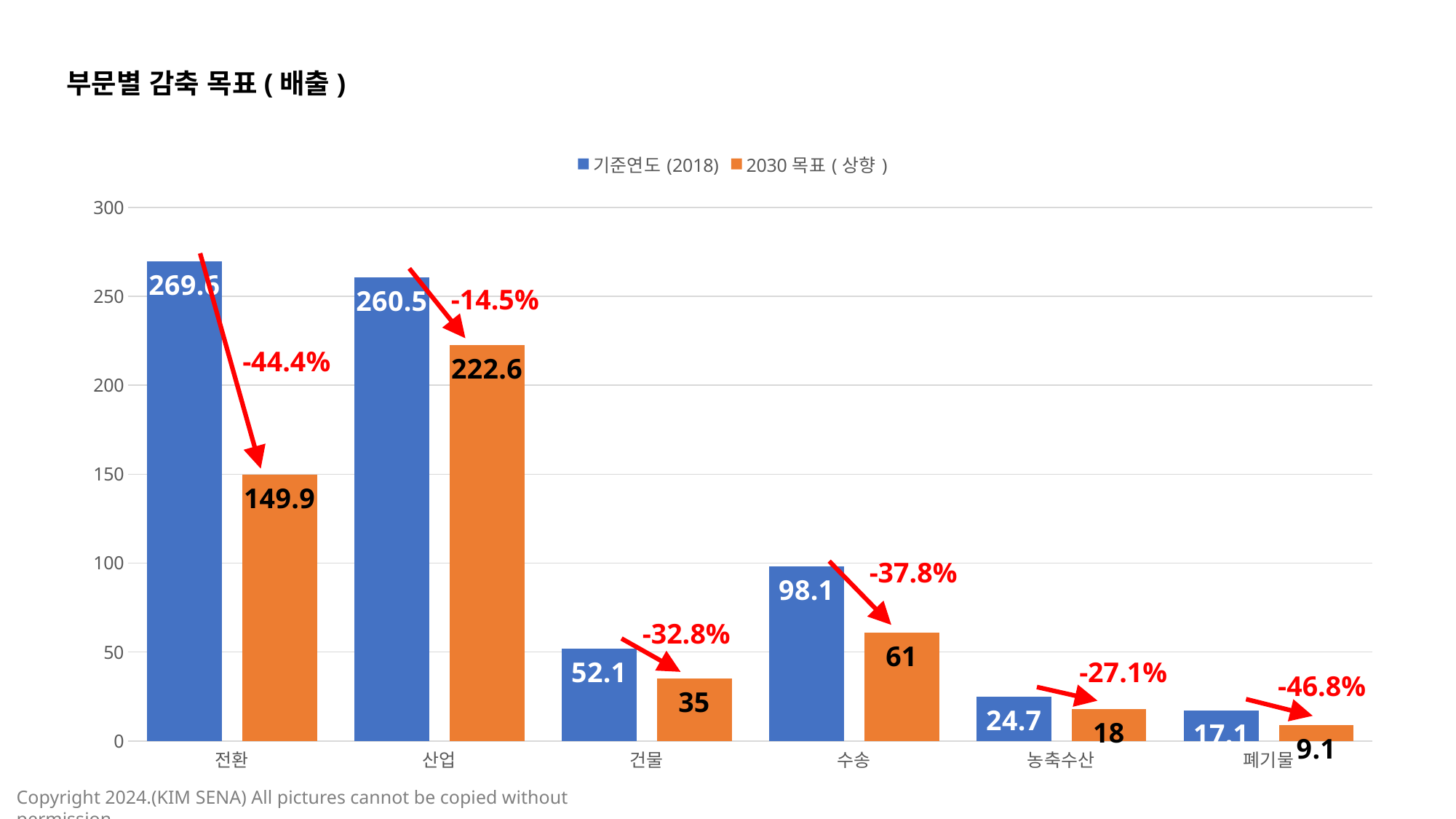
What kind of chart is shown on the slide? bar chart What percentage change is annotated in red for 폐기물? -46.8% What is the 2030 목표 ( 상향 ) value for 수송? 61 What is the 기준연도 (2018) value for 전환? 269.5 Which category has the lowest 2030 목표 ( 상향 ) value? 폐기물 Which is larger: the 2030 목표 ( 상향 ) value for 전환 or the 2030 목표 ( 상향 ) value for 산업? 산업 Which category has the highest 기준연도 (2018) value? 전환 What is the 2030 목표 ( 상향 ) value for 산업? 222.6 What is the title of the chart? 부문별 감축 목표 ( 배출 ) How many series does the legend list? 2 How many categories are shown on the x axis? 6 What is the difference between the 기준연도 (2018) and 2030 목표 ( 상향 ) values for 건물? 17.1